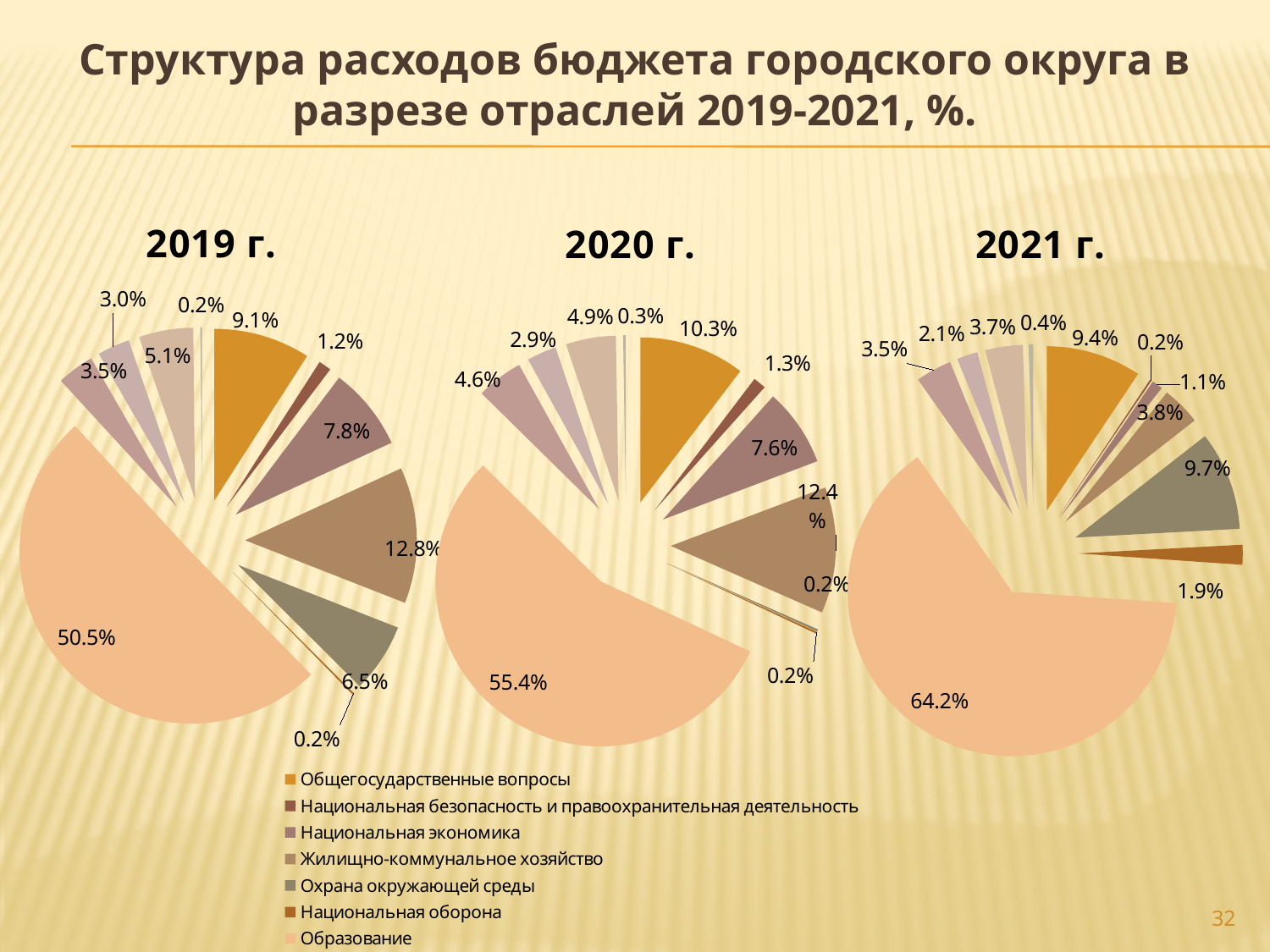
In the 2020 г. pie chart, what share is shown for Общегосударственные вопросы? 10.3% In the 2021 г. pie chart, which category has the largest share? Образование Does the share of Образование rise or fall from the 2019 г. chart to the 2021 г. chart? rises What kind of charts are shown on the slide? pie charts In the 2021 г. pie chart, what share is shown for Образование? 64.2% In the 2019 г. pie chart, what share is shown for Образование (the largest slice)? 50.5% In the 2021 г. pie chart, what share is shown for Общегосударственные вопросы? 9.4% By how many percentage points does the share of Образование in 2021 г. exceed its share in 2019 г.? 13.7 Which is larger: the share of Общегосударственные вопросы in 2020 г. or in 2019 г.? 2020 г. In the 2020 г. pie chart, what share is shown for Образование? 55.4% How many categories does the legend list? 7 In the 2019 г. pie chart, what share is shown for Общегосударственные вопросы? 9.1%